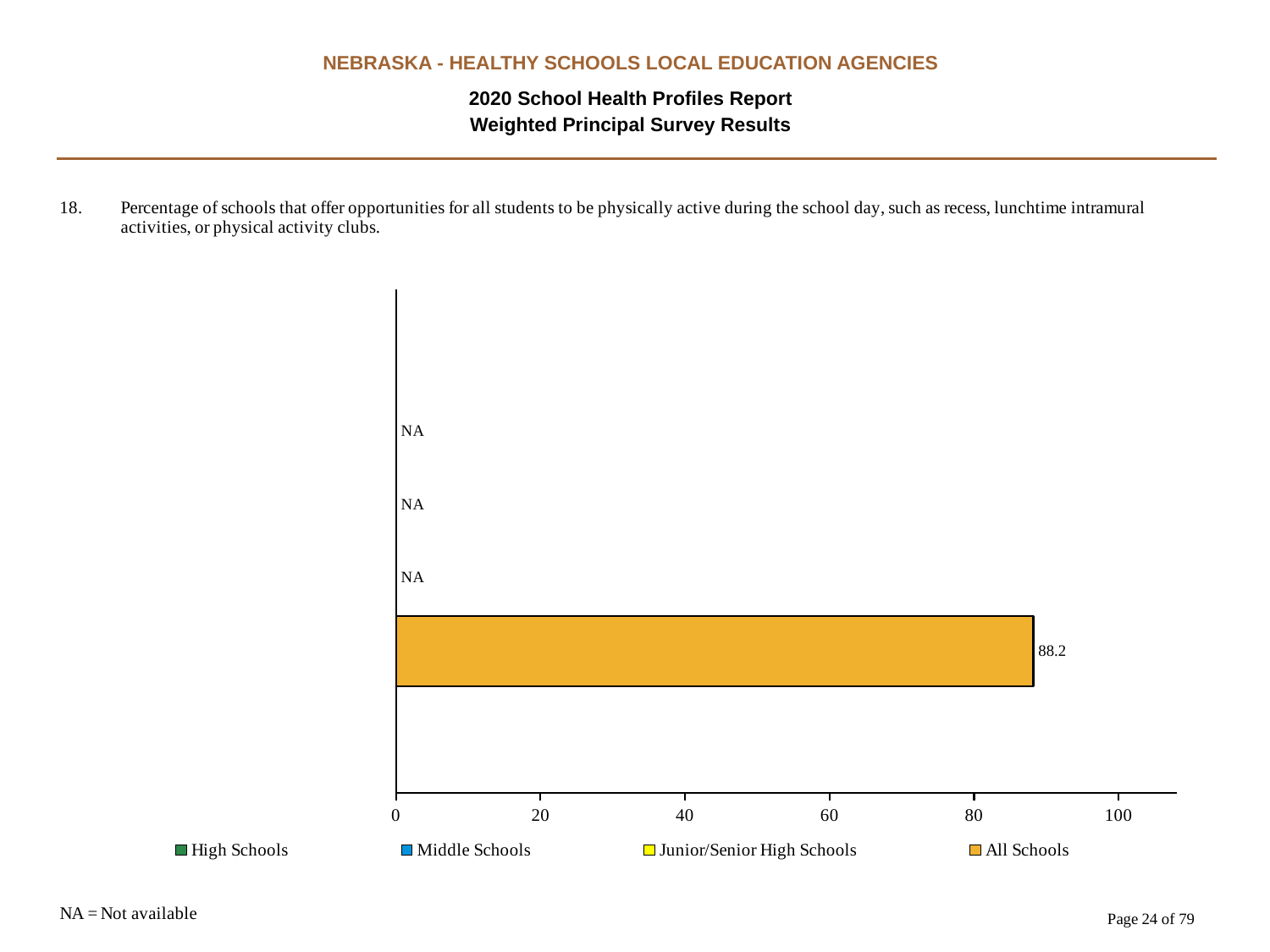
How many series have a plotted bar with a numeric value? 1 How many series does the legend list? 4 Is the value for All Schools greater or less than 80? greater What value is shown for High Schools? NA What is the highest value shown on the x axis? 100 What does NA stand for according to the note on the slide? Not available Which series is the only one with a plotted bar? All Schools Is the value for All Schools greater or less than 100? less What value is shown for Junior/Senior High Schools? NA What value is shown for Middle Schools? NA What is the value for All Schools? 88.2 What kind of chart is shown on the slide? bar chart